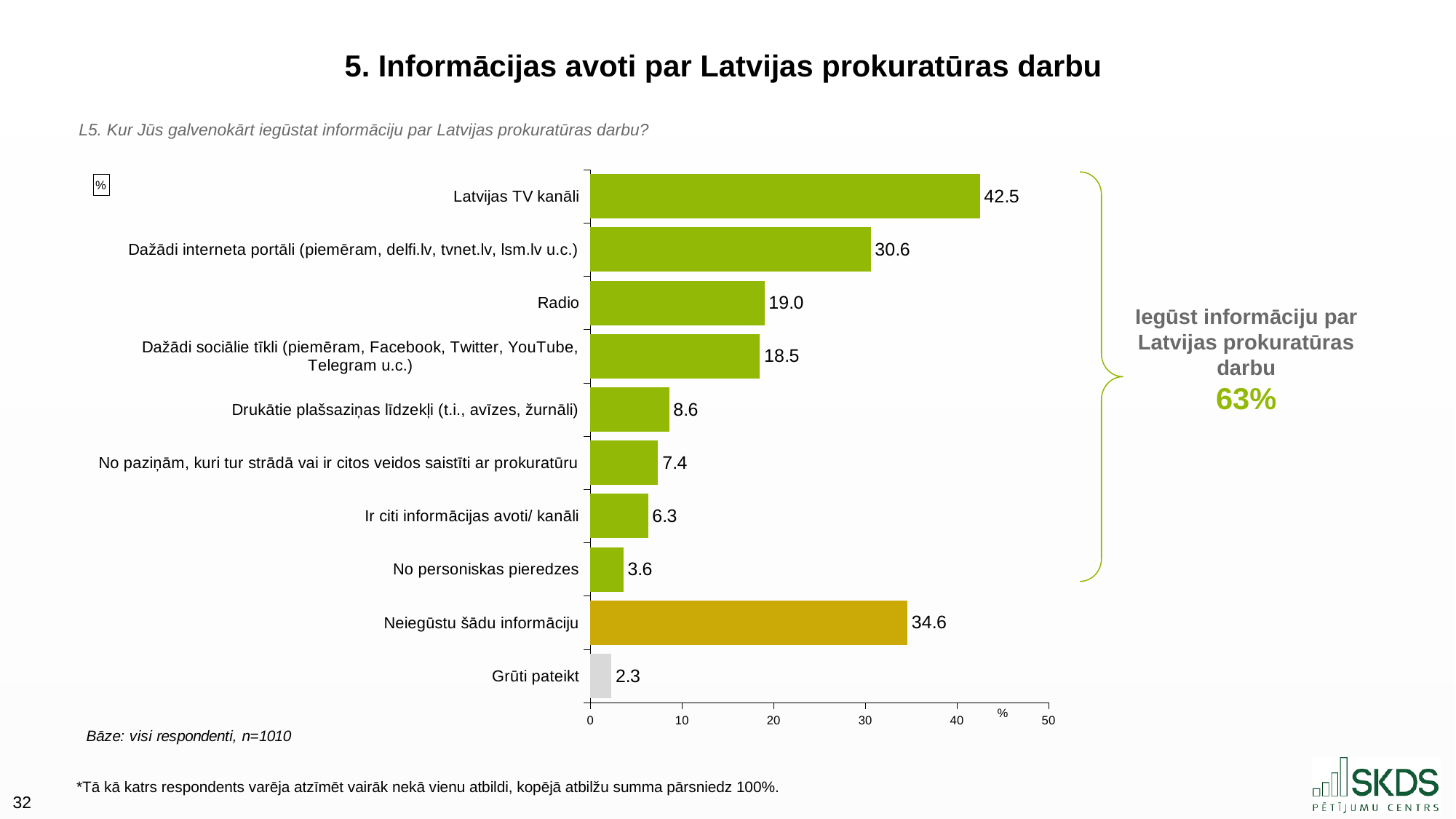
What is the value for Latvijas TV kanāli? 42.5 What is the value for Grūti pateikt? 2.3 Is the value for Neiegūstu šādu informāciju greater or less than 30? greater What percentage is shown next to the bracket labelled 'Iegūst informāciju par Latvijas prokuratūras darbu'? 63% How many categories are shown in the chart? 10 What kind of chart is shown on the slide? bar chart What is the value for Radio? 19.0 What is the difference between the values for Latvijas TV kanāli and Dažādi interneta portāli (piemēram, delfi.lv, tvnet.lv, lsm.lv u.c.)? 11.9 Which category has the lowest value? Grūti pateikt Which category has the highest value? Latvijas TV kanāli What is the value for Neiegūstu šādu informāciju? 34.6 Which is larger: the value for Radio or the value for Dažādi sociālie tīkli (piemēram, Facebook, Twitter, YouTube, Telegram u.c.)? Radio